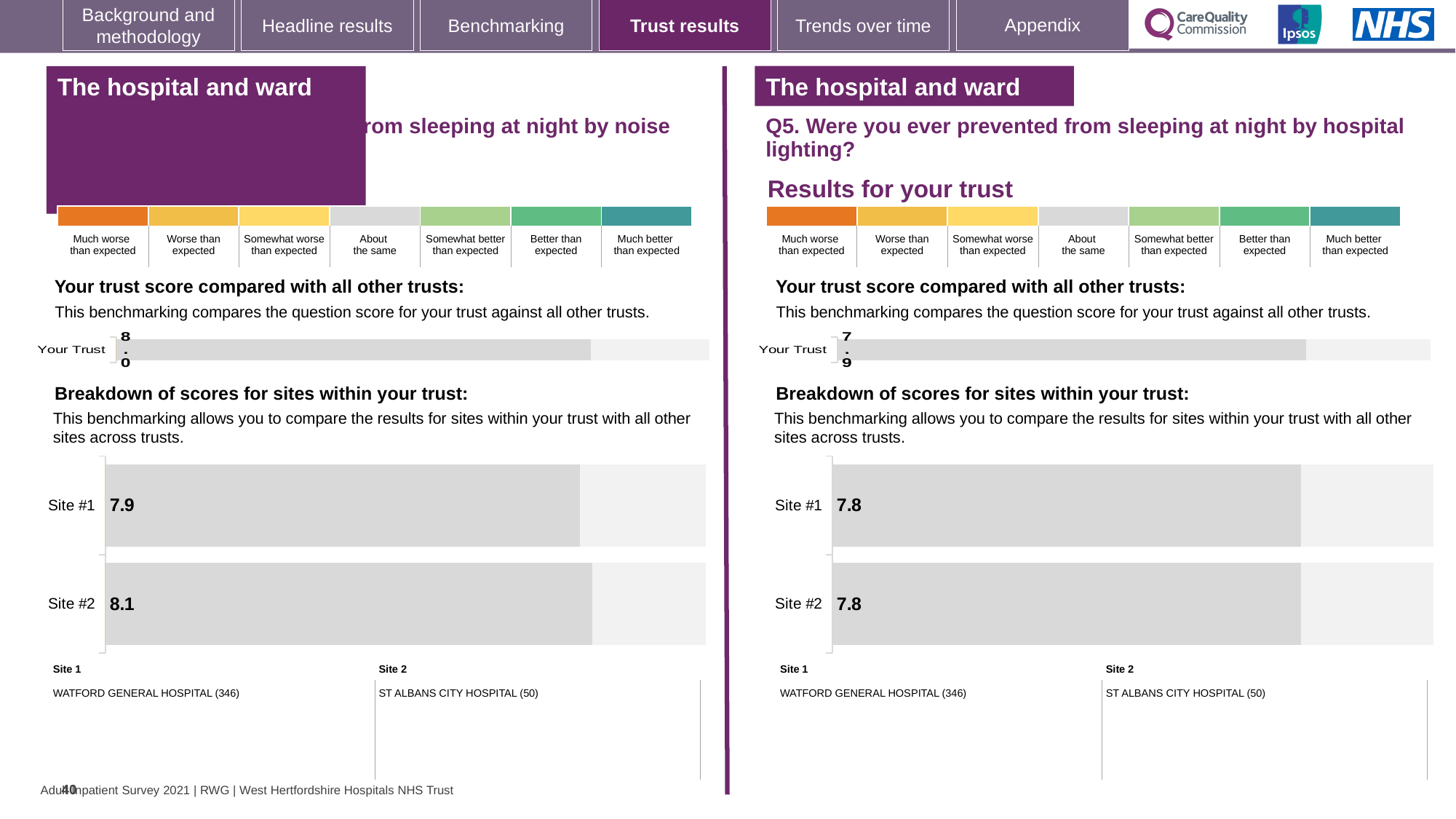
On the left-hand site breakdown chart, which site has the higher score? Site #2 On the left-hand chart (sleeping at night by noise), what is the score for Your Trust? 8.0 On the left-hand site breakdown chart, what is the score for Site #1? 7.9 On the right-hand site breakdown chart (Q5), what is the difference between the Site #1 and Site #2 scores? 0.0 On the left-hand site breakdown chart, what is the difference between the Site #2 and Site #1 scores? 0.2 According to the site key on the right-hand side, which hospital is Site 1? WATFORD GENERAL HOSPITAL (346) On the left-hand site breakdown chart, what is the score for Site #2? 8.1 What type of chart is used for the site breakdown on the right-hand side (Q5)? Bar chart On the right-hand site breakdown chart (Q5), what is the score for Site #1? 7.8 On the right-hand chart (Q5, hospital lighting), what is the score for Your Trust? 7.9 On the right-hand site breakdown chart (Q5), what is the score for Site #2? 7.8 How many sites are shown in the left-hand site breakdown chart? 2